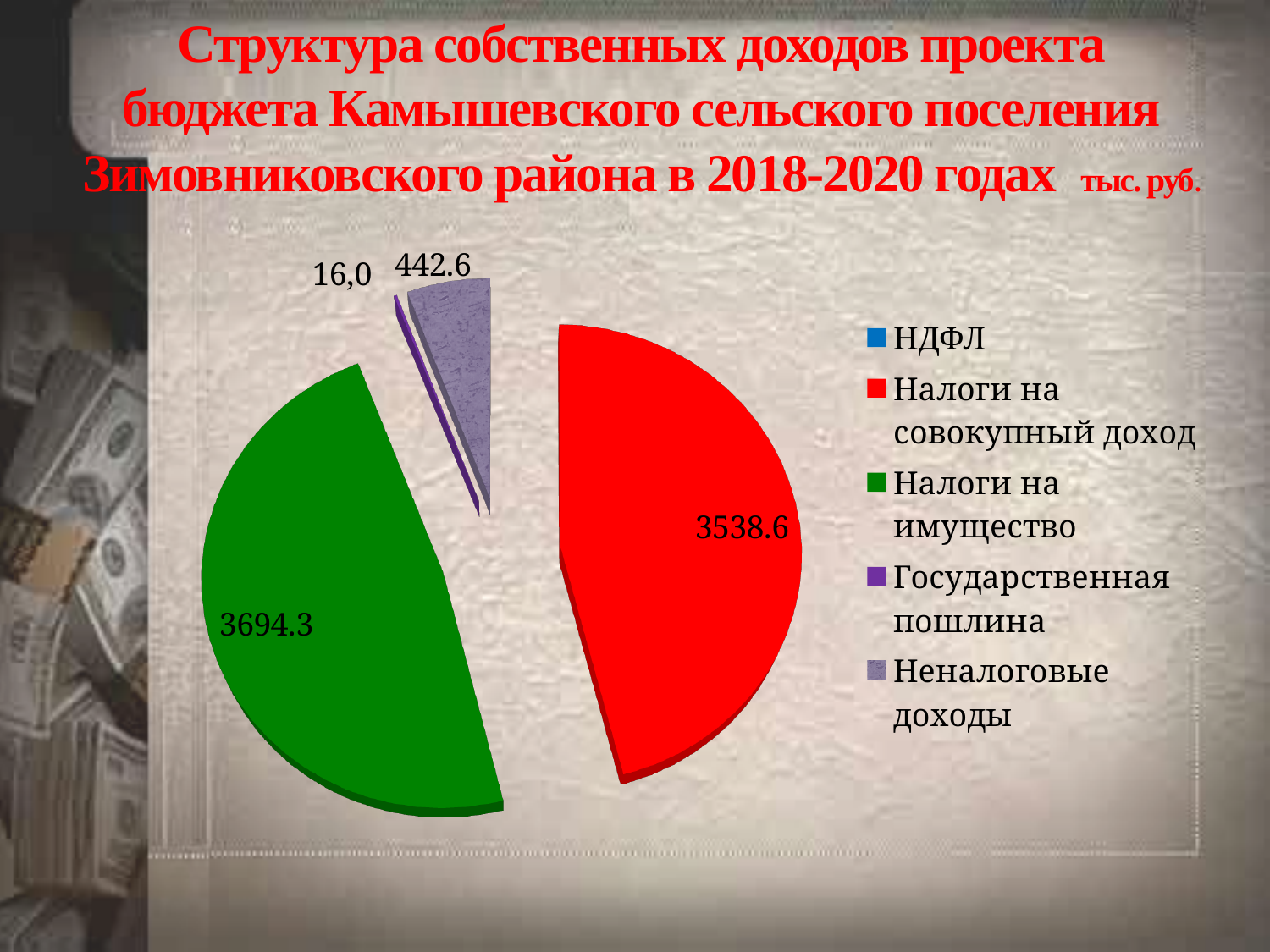
How many categories does the legend list? 5 What colour is the slice for Налоги на совокупный доход? red Which is larger: Неналоговые доходы or Государственная пошлина? Неналоговые доходы What is the value for Неналоговые доходы? 442.6 What is the difference between the values for Неналоговые доходы and Государственная пошлина? 426.6 What is the difference between the values for Налоги на имущество and Налоги на совокупный доход? 155.7 What is the value for Налоги на совокупный доход? 3538.6 What is the value for Налоги на имущество? 3694.3 Which labelled category has the largest value? Налоги на имущество Which labelled category has the smallest value? Государственная пошлина What kind of chart is shown on the slide? pie chart What is the value for Государственная пошлина? 16,0